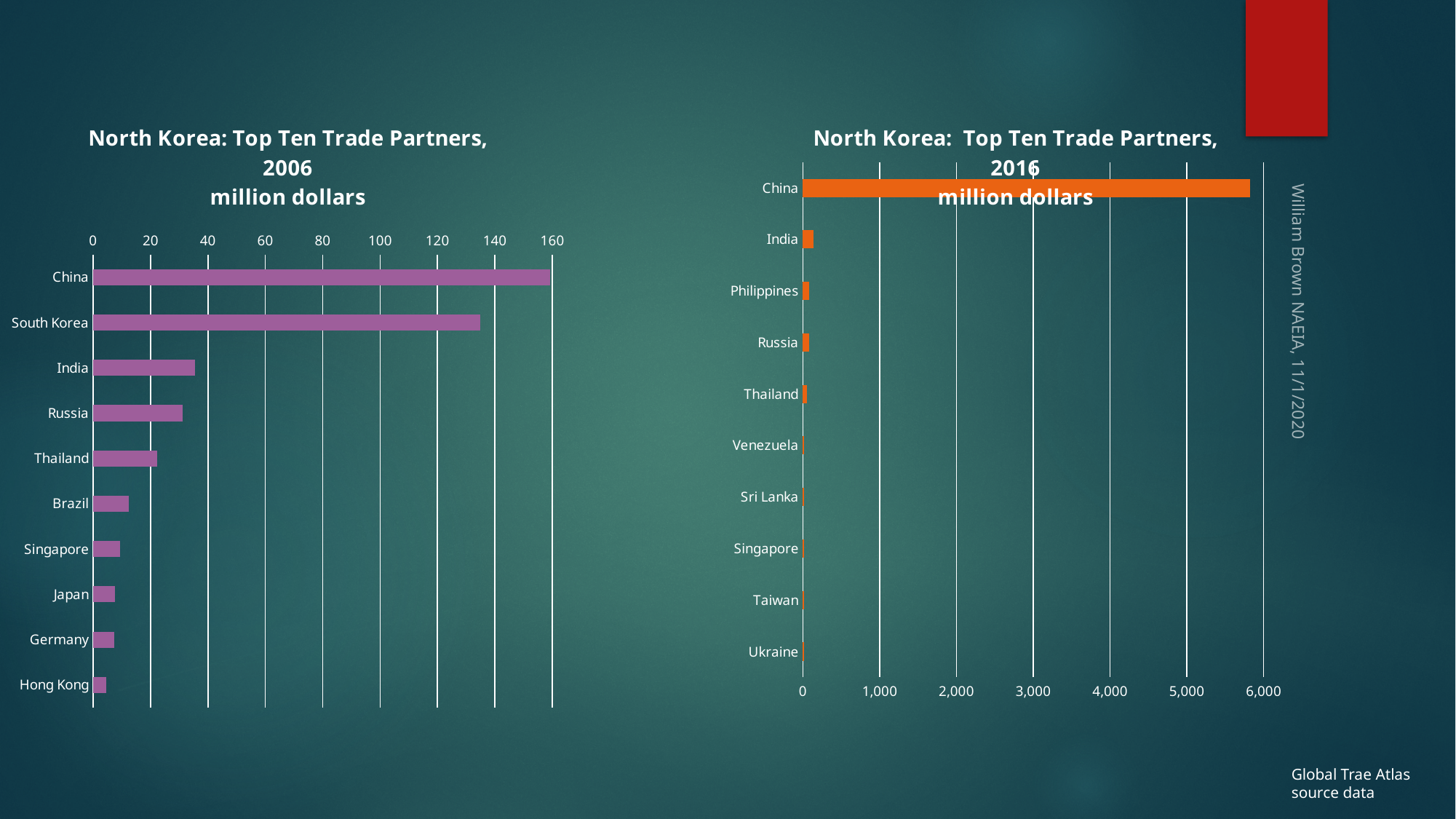
In the 'North Korea: Top Ten Trade Partners, 2016' chart, is the value for India greater or less than 1,000? less In the 'North Korea: Top Ten Trade Partners, 2006' chart, which is larger, the value for Russia or the value for Thailand? Russia How many trade partners are shown in the 'North Korea: Top Ten Trade Partners, 2006' chart? 10 How many trade partners are shown in the 'North Korea: Top Ten Trade Partners, 2016' chart? 10 In the 'North Korea: Top Ten Trade Partners, 2006' chart, is the value for South Korea greater or less than 120? greater In the 'North Korea: Top Ten Trade Partners, 2016' chart, is the value for China greater or less than 5,000? greater What kind of chart is the 'North Korea: Top Ten Trade Partners, 2006' chart? bar chart In the 'North Korea: Top Ten Trade Partners, 2006' chart, which trade partner has the highest value? China What unit is stated in the title of the 'North Korea: Top Ten Trade Partners, 2016' chart? million dollars In the 'North Korea: Top Ten Trade Partners, 2016' chart, which trade partner has the highest value? China In the 'North Korea: Top Ten Trade Partners, 2006' chart, which trade partner has the lowest value? Hong Kong